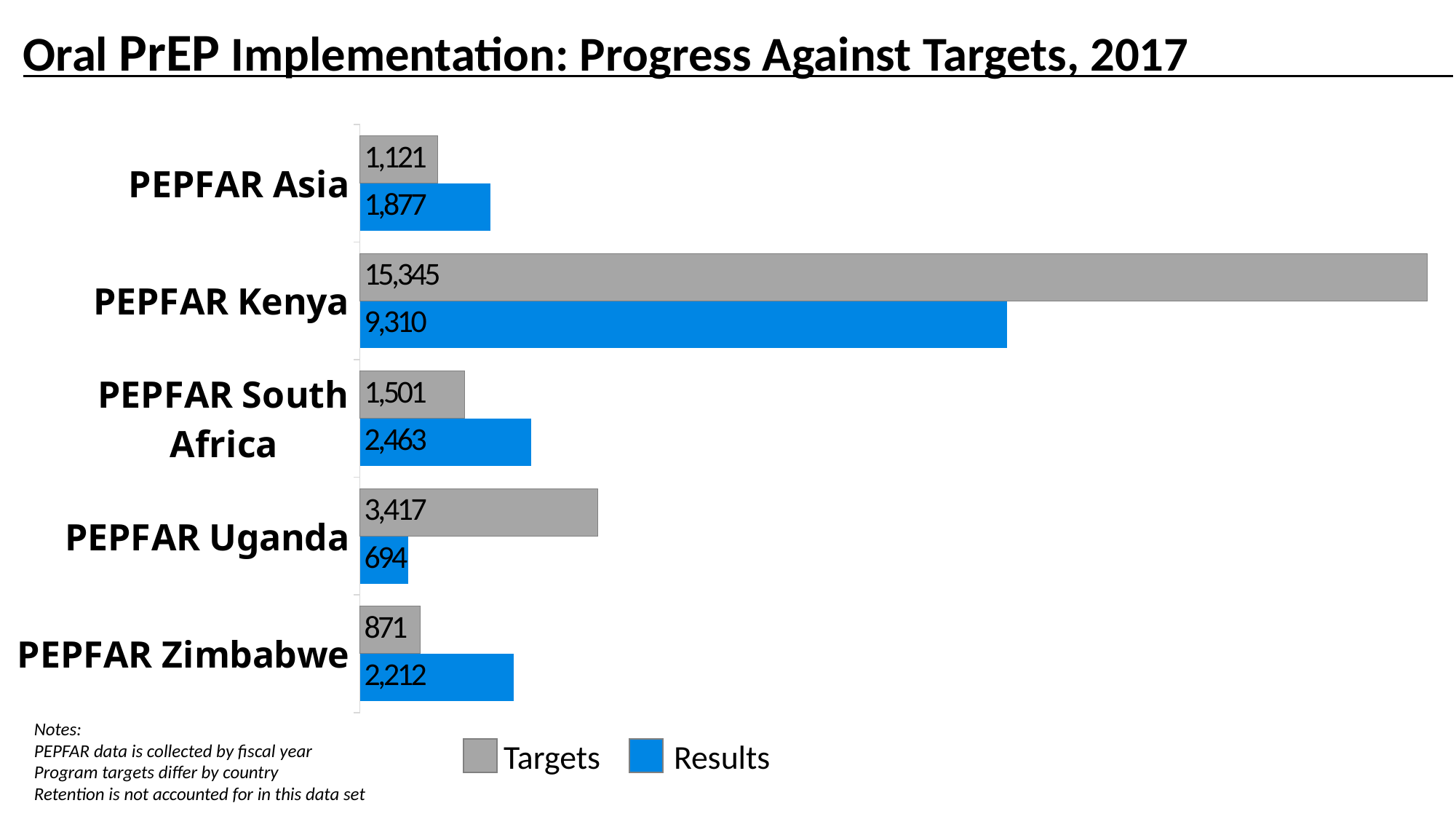
What kind of chart is shown on the slide? Bar chart What is the difference between the Results and Targets values for PEPFAR Asia? 756 How many series does the legend list? 2 What is the Results value for PEPFAR Uganda? 694 What is the Results value for PEPFAR Zimbabwe? 2,212 What is the difference between the Targets and Results values for PEPFAR Kenya? 6,035 Which category has the lowest Targets value? PEPFAR Zimbabwe What is the Targets value for PEPFAR South Africa? 1,501 What is the Targets value for PEPFAR Kenya? 15,345 Which is larger for PEPFAR Uganda, the Targets value or the Results value? Targets How many categories are shown on the chart? 5 Which category has the highest Results value? PEPFAR Kenya